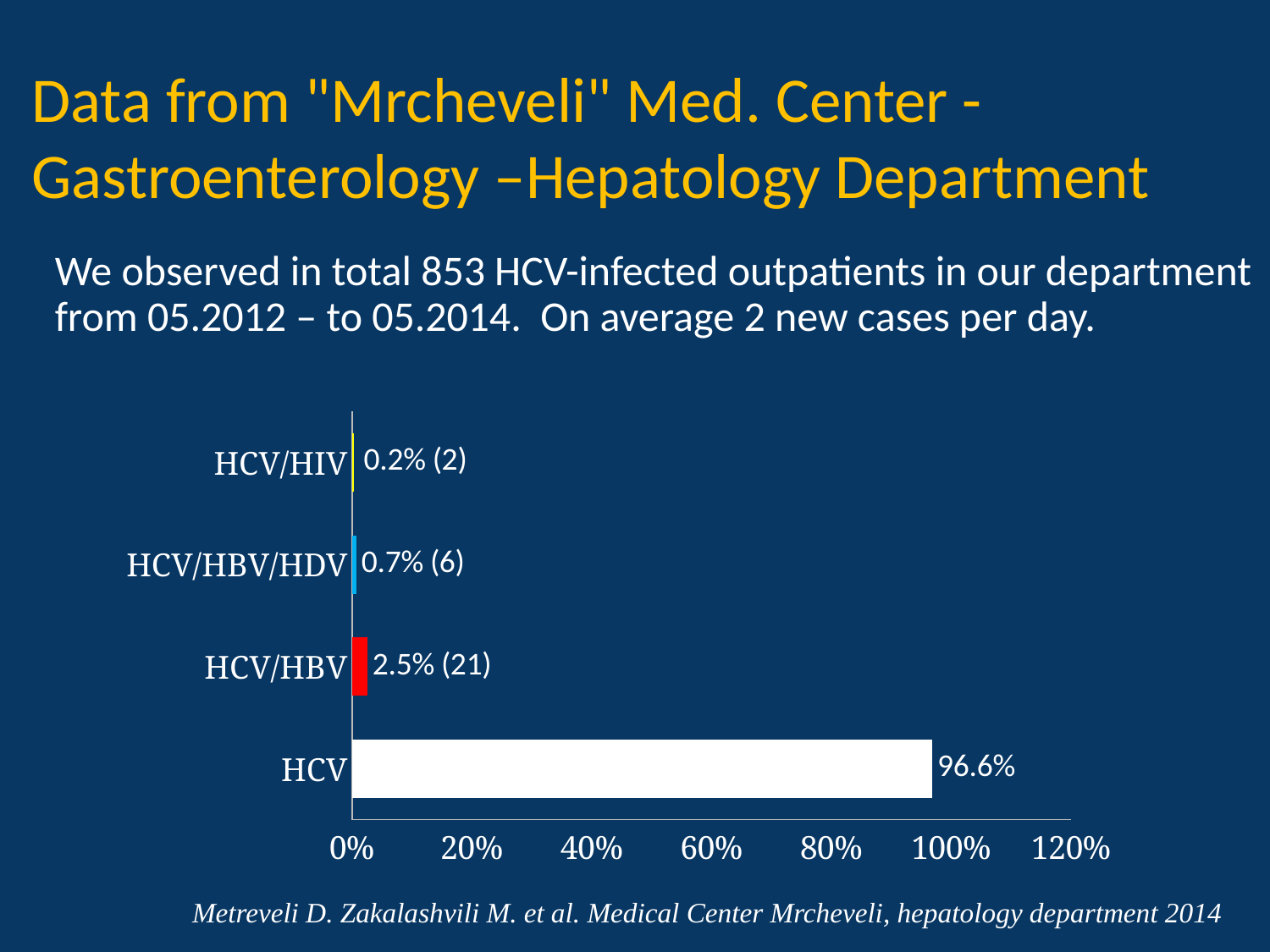
What percentage is shown for HCV/HBV? 2.5% Is the value for HCV greater or less than 80%? greater Which is larger, the percentage for HCV/HBV or for HCV/HIV? HCV/HBV What kind of chart is shown on the slide? bar chart How many cases are shown in parentheses for HCV/HBV/HDV? 6 How many categories are shown on the chart? 4 What percentage is shown for HCV/HIV? 0.2% Which category has the lowest percentage? HCV/HIV What colour is the bar for HCV/HBV? red What percentage is shown for HCV? 96.6% What is the difference in percentage between HCV/HBV and HCV/HBV/HDV? 1.8% Which category has the highest percentage? HCV